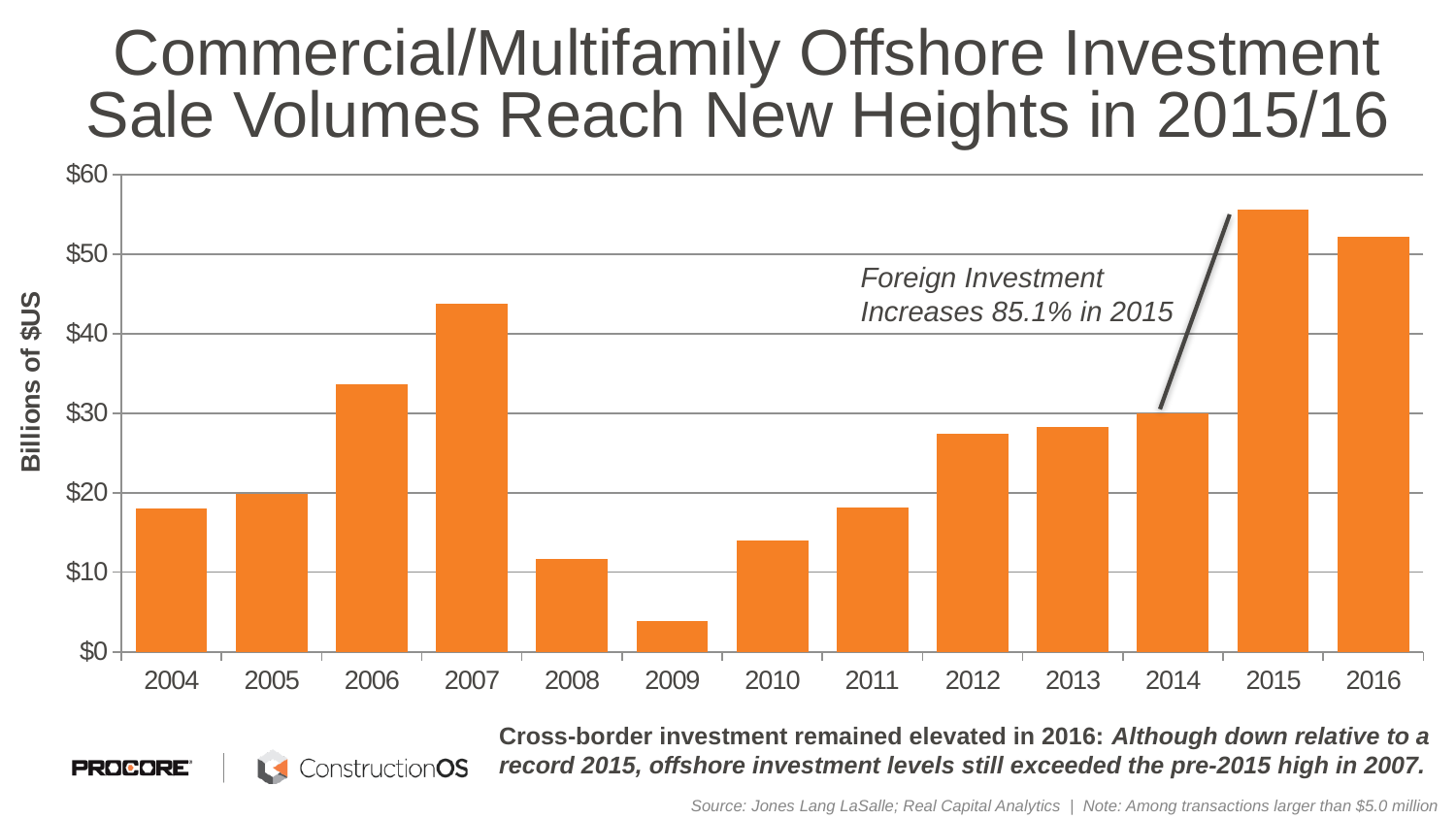
Is the value for 2007 greater or less than $40? greater Is the value for 2009 greater or less than $10? less Is the value for 2016 greater or less than $50? greater Which year has the larger value, 2007 or 2016? 2016 What is the label on the y axis? Billions of $US What kind of chart is shown on the slide? bar chart How many years are plotted on the x axis? 13 Which year has the lowest offshore investment sale volume? 2009 Which year has the larger value, 2006 or 2012? 2006 Which year has the highest offshore investment sale volume? 2015 Do the values rise or fall from 2009 to 2015? rise